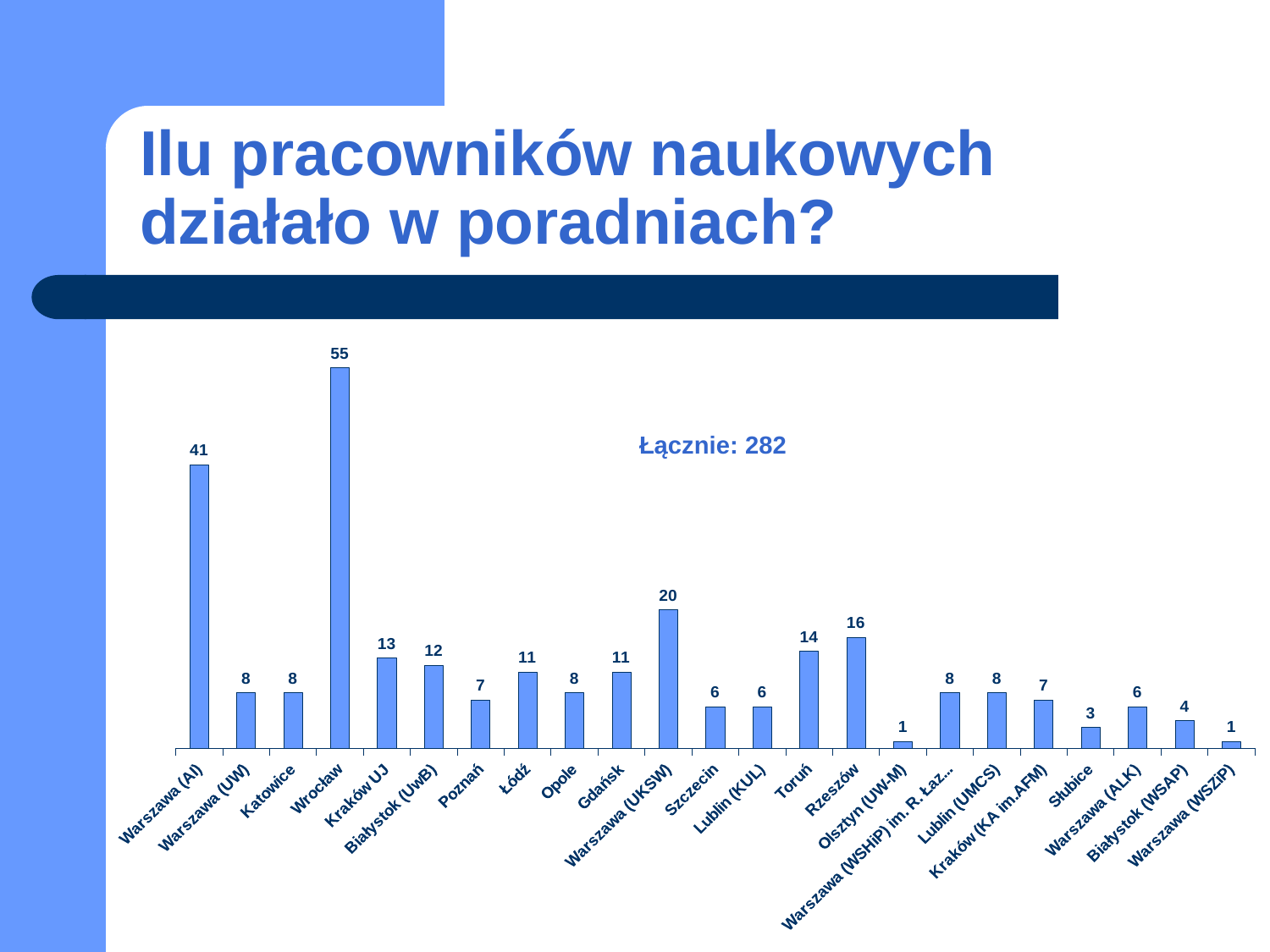
What is the value for Słubice? 3 What is the value for Rzeszów? 16 How many categories are shown on the x axis? 23 What type of chart is shown on the slide? bar chart Which is larger, the value for Białystok (UwB) or the value for Gdańsk? Białystok (UwB) What is the value for Warszawa (UKSW)? 20 Which category has the highest value? Wrocław Which is larger, the value for Rzeszów or the value for Toruń? Rzeszów What is the difference between the values for Toruń and Kraków UJ? 1 What total is stated in the text label inside the chart area? Łącznie: 282 What is the difference between the values for Wrocław and Warszawa (AI)? 14 How many scientific staff are shown for Wrocław? 55